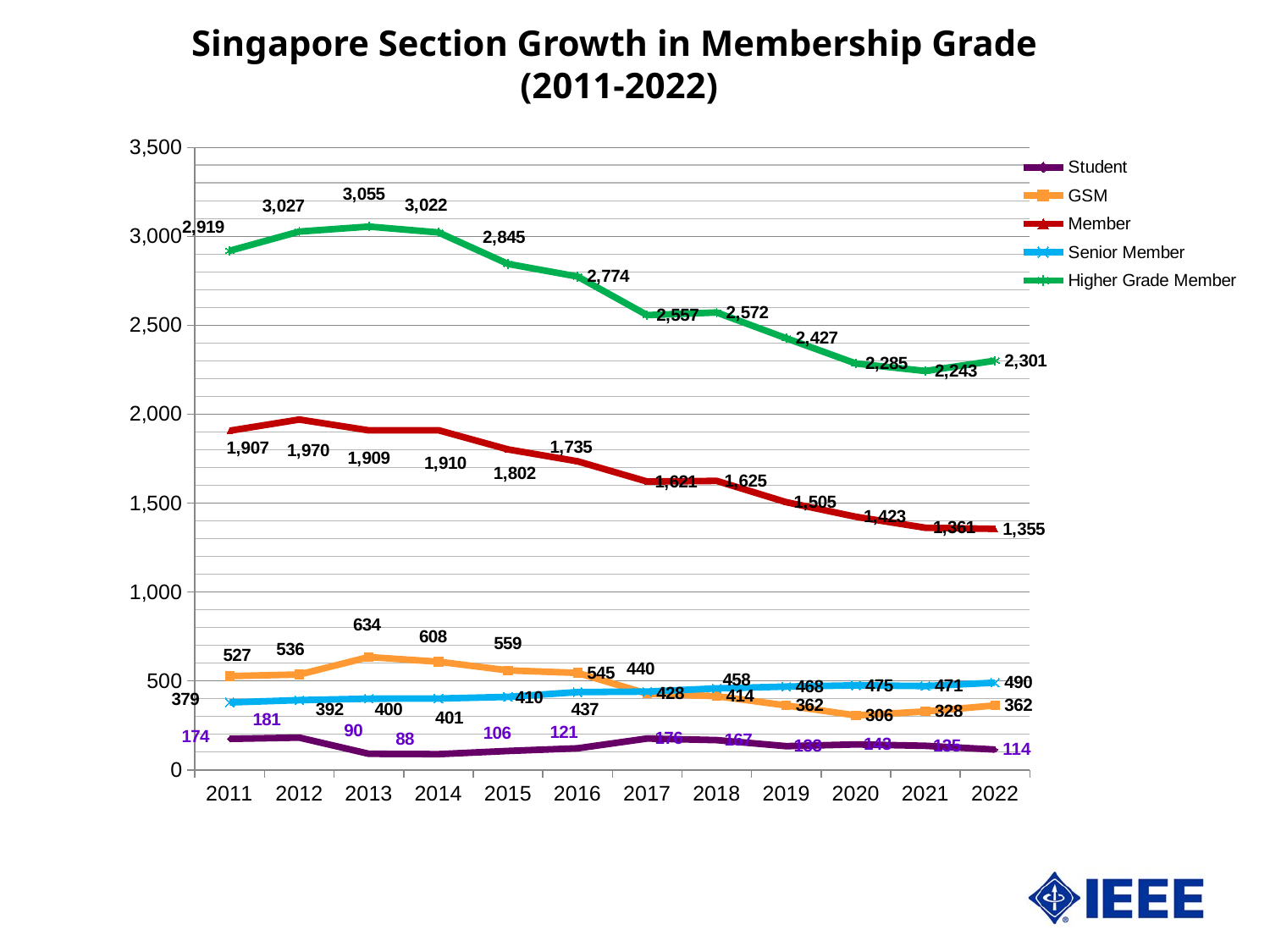
Does the Member series rise or fall overall from 2011 to 2022? fall In which year is the GSM series at its lowest? 2020 What is the Senior Member value for 2022? 490 What kind of chart is shown on the slide? line chart In which year is the Higher Grade Member series at its highest? 2013 How many years are plotted along the x axis? 12 In 2016, which is larger: GSM or Senior Member? GSM What is the Member value for 2022? 1,355 How many series does the legend list? 5 What is the Higher Grade Member value for 2013? 3,055 Is the Higher Grade Member value for 2020 greater or less than 2,500? less What is the difference between the Member value in 2011 and in 2022? 552